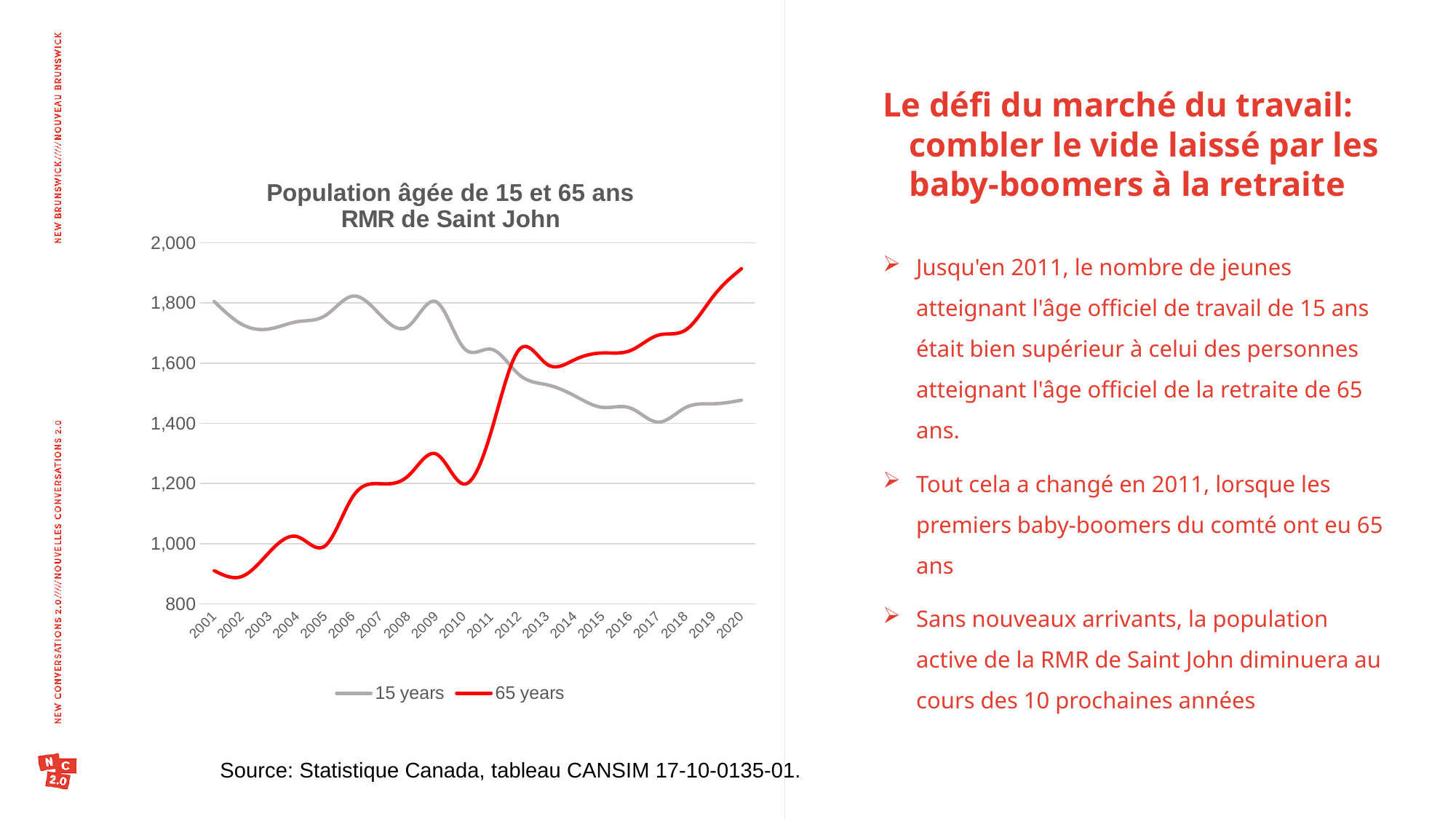
What kind of chart is shown on the slide? line chart What is the title of the chart? Population âgée de 15 et 65 ans RMR de Saint John How many years are shown along the x axis? 20 In which year does the 15 years series reach its lowest value? 2017 How many series does the legend list? 2 Is the value for 65 years in 2020 greater or less than 1,800? greater Is the value for 65 years in 2001 greater or less than 1,000? less Which series is drawn in red? 65 years In 2005, which series has the larger value, 15 years or 65 years? 15 years In which year does the 65 years series reach its highest value? 2020 Does the 15 years series rise or fall overall from 2001 to 2020? fall Does the 65 years series rise or fall overall from 2001 to 2020? rise